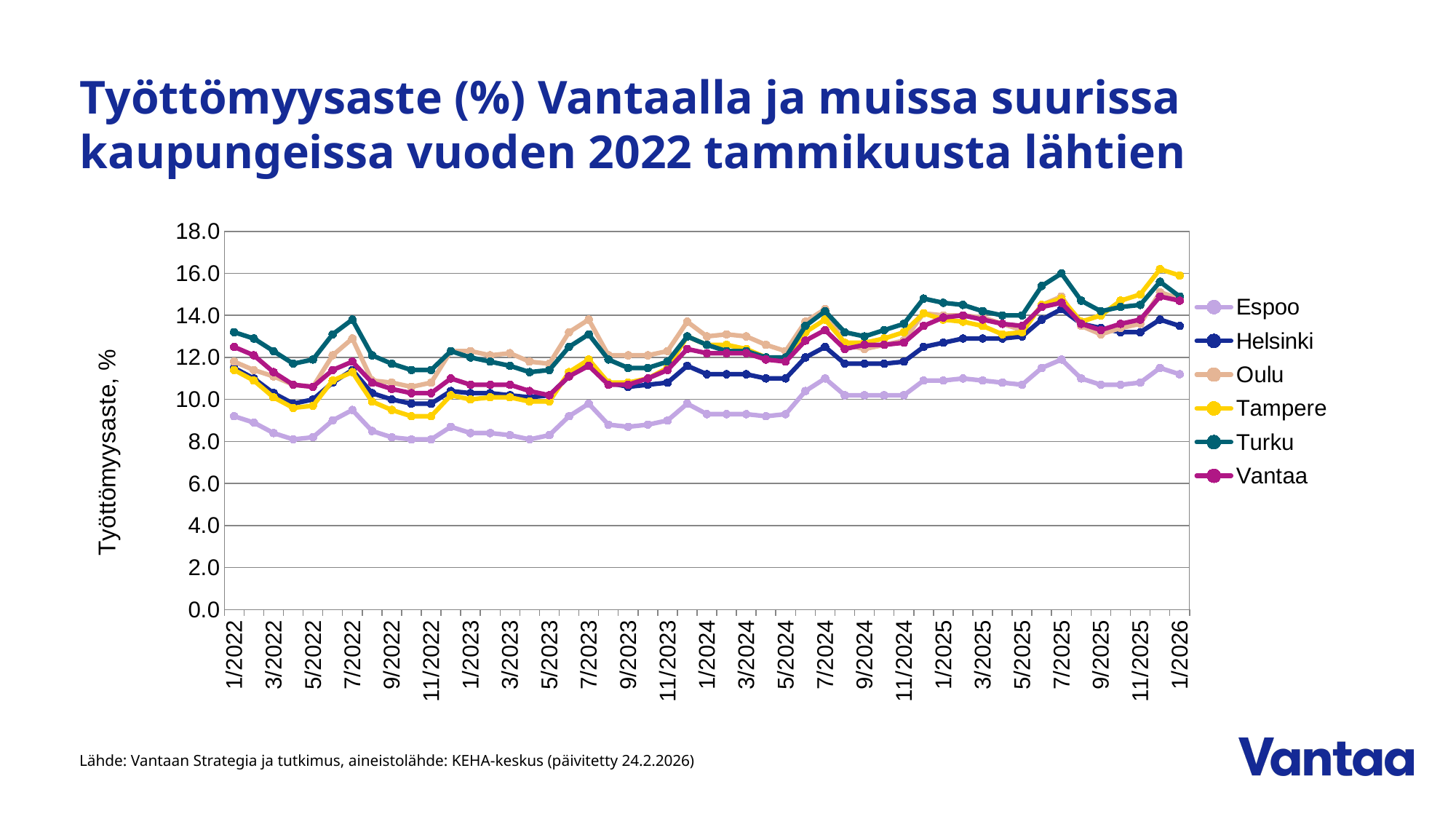
Is the value for Espoo in 1/2022 greater or less than 10? less Does the unemployment rate for Vantaa overall rise or fall from 1/2022 to 1/2026? rise Is the value for Helsinki in 1/2022 greater or less than 10? greater Which city has the highest unemployment rate in 7/2025? Turku In 1/2026, which is larger, the value for Helsinki or the value for Espoo? Helsinki Is the value for Vantaa in 1/2026 greater or less than 14? greater What is the title of the chart? Työttömyysaste (%) Vantaalla ja muissa suurissa kaupungeissa vuoden 2022 tammikuusta lähtien How many series does the legend list? 6 Which city has the lowest unemployment rate throughout the whole period shown? Espoo What is the label of the y axis? Työttömyysaste, % What kind of chart is shown on the slide? line chart